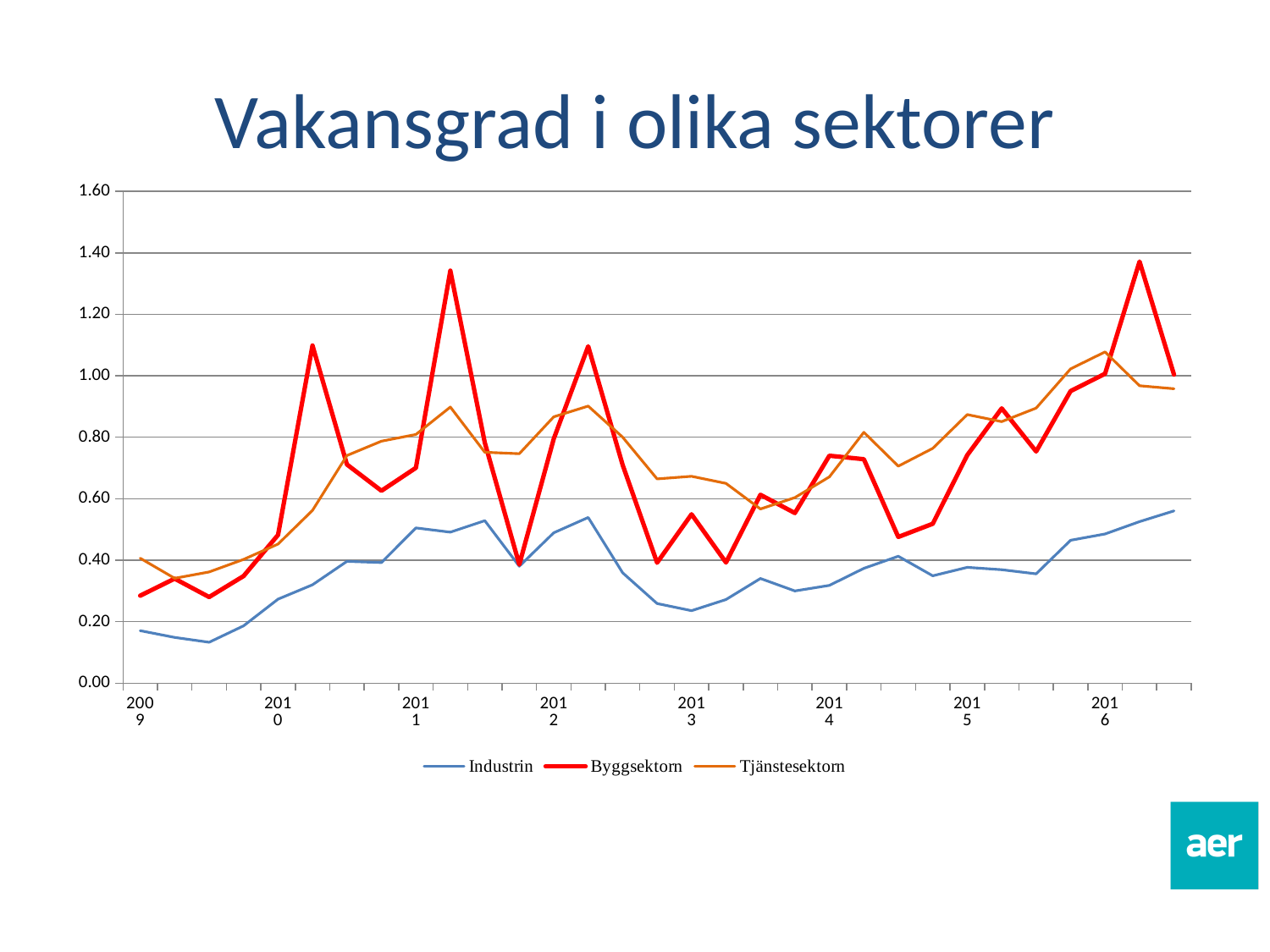
How many years are labelled on the x axis? 8 Is the peak of Tjänstesektorn in 2016 greater or less than 1.00? greater Which series is drawn in red? Byggsektorn Is the value for Industrin at the start of 2013 greater or less than 0.40? less Which series has the lowest values for most of the period shown? Industrin At the start of 2009, which is higher, Tjänstesektorn or Industrin? Tjänstesektorn How many series does the legend list? 3 Is the highest peak of Byggsektorn in 2016 greater or less than 1.20? greater What is the title of the chart? Vakansgrad i olika sektorer Does the Industrin series generally rise or fall from 2013 to 2016? rise What kind of chart is shown on the slide? line chart